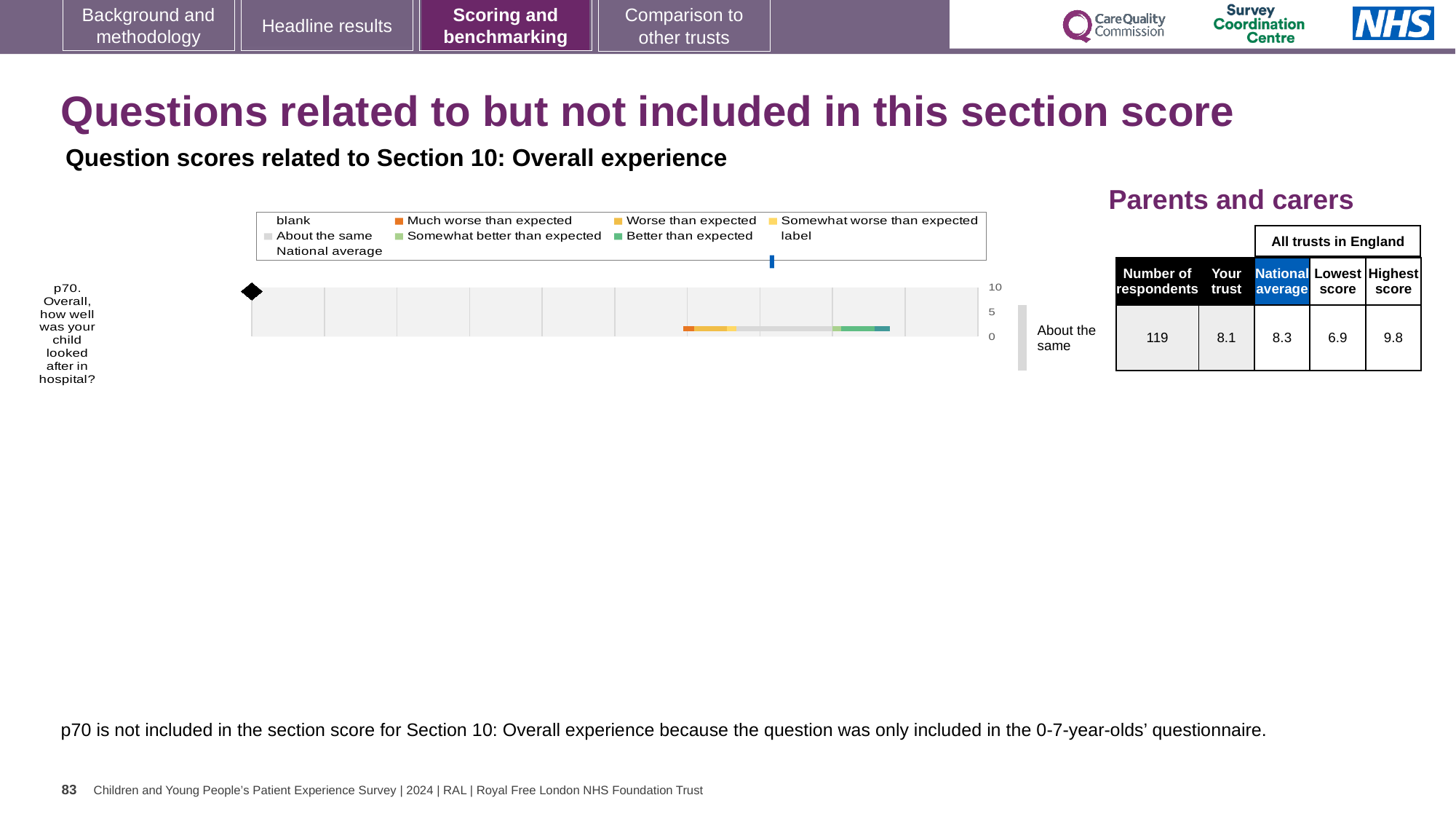
How many survey questions are plotted in the chart? 1 For p70, which is larger: the 'Your trust' score or the national average? National average What is the highest score among all trusts in England for p70? 9.8 What is the lowest score among all trusts in England for p70? 6.9 How many respondents answered p70 according to the Parents and carers table? 119 What is the national average score for p70 in the Parents and carers table? 8.3 By how much does the national average exceed the 'Your trust' score for p70? 0.2 What kind of chart is shown for p70 on the slide? bar chart What is the 'Your trust' score for p70 in the Parents and carers table? 8.1 Which question is plotted in the chart? p70. Overall, how well was your child looked after in hospital? What comparison label is shown to the right of the p70 bar? About the same What is the difference between the highest and lowest trust scores for p70? 2.9